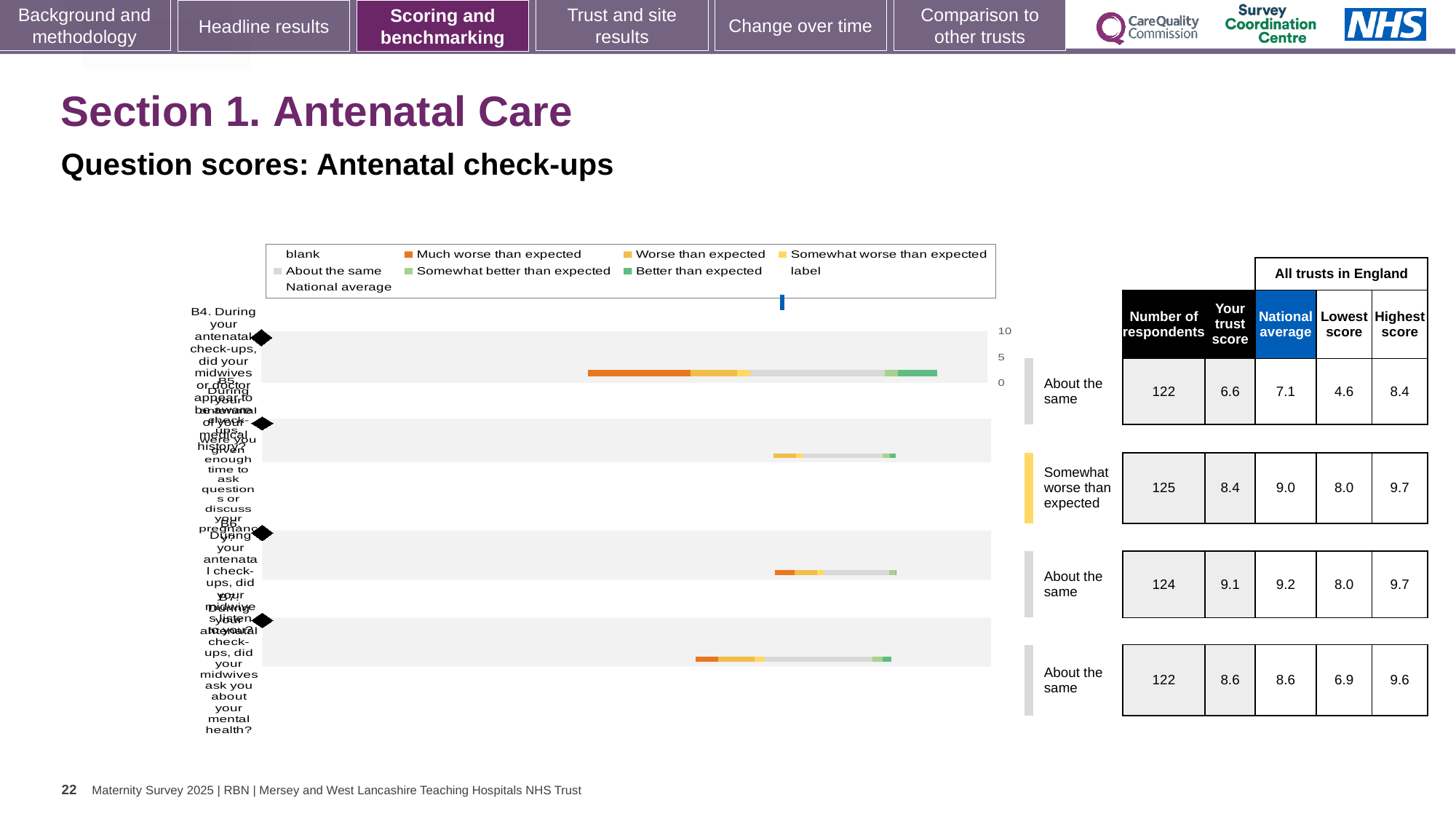
Is the trust score for the second question row larger or smaller than its national average? smaller Which question row has the highest trust score in the table beside the chart? the third row (9.1) In the table beside the chart, what is the highest score for the second question row? 9.7 How many question bars are plotted in the chart? 4 In the table beside the chart, what is the national average for the first question (B4)? 7.1 What kind of chart is shown on the slide? bar chart What benchmark label is shown for the second question row? Somewhat worse than expected Which question row has the lowest trust score in the table beside the chart? the first row, B4 (6.6) In the table beside the chart, what is the number of respondents for the first question (B4)? 122 In the table beside the chart, what is the trust score for the first question (B4)? 6.6 In the table beside the chart, what is the lowest score for the fourth question row? 6.9 What is the difference between the national average and the trust score for the first question (B4)? 0.5